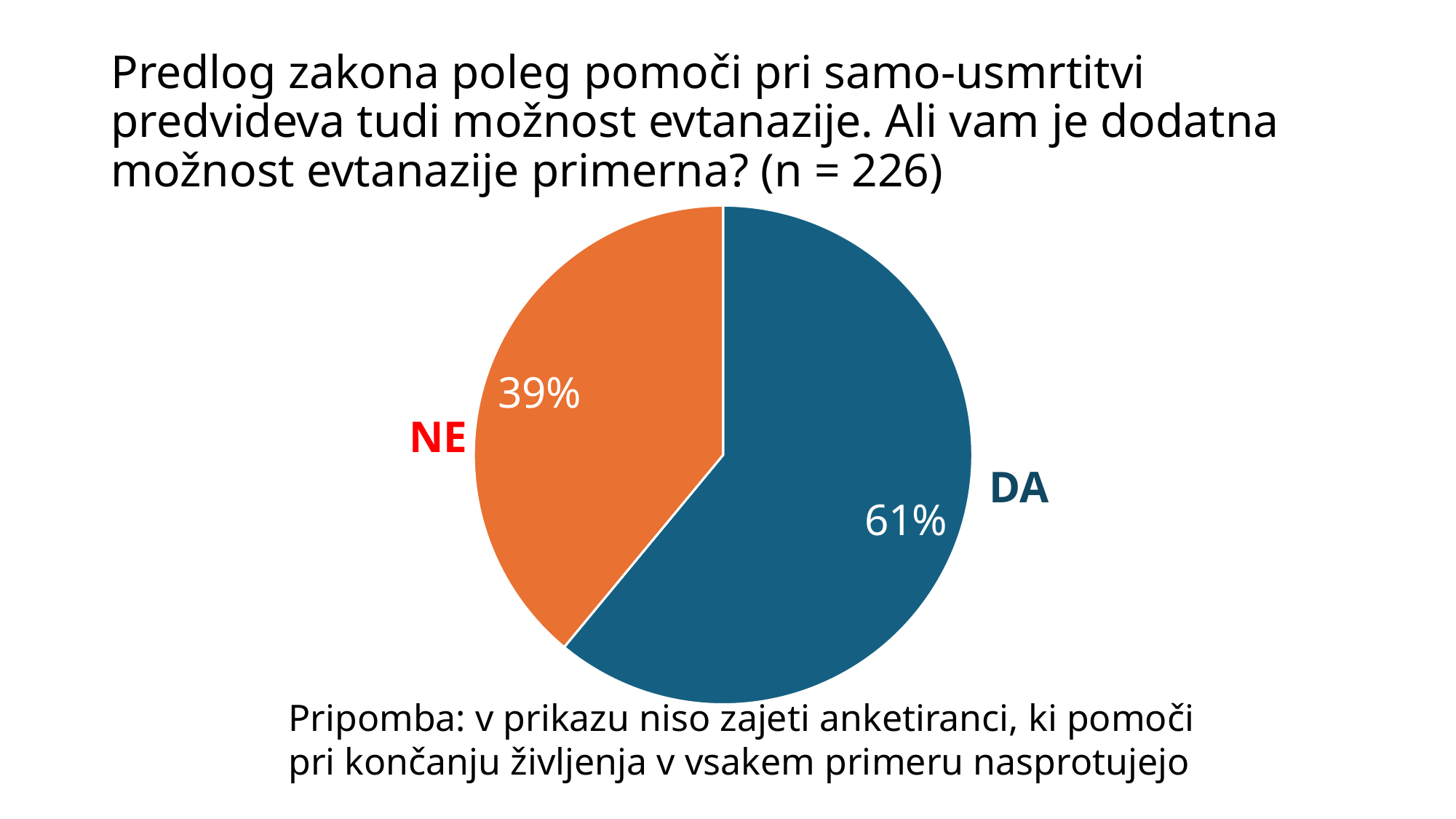
Which answer has the smallest share of the pie? NE What percentage of respondents answered DA? 61% What is the difference in percentage points between the DA and NE slices? 22 How many slices does the pie chart have? 2 What colour is the NE slice? orange What kind of chart is shown on the slide? pie chart Which answer has the largest share of the pie? DA What share of the pie does the DA slice represent? 61% What is the sample size (n) stated in the chart title? 226 What percentage of respondents answered NE? 39% Which slice is larger, DA or NE? DA